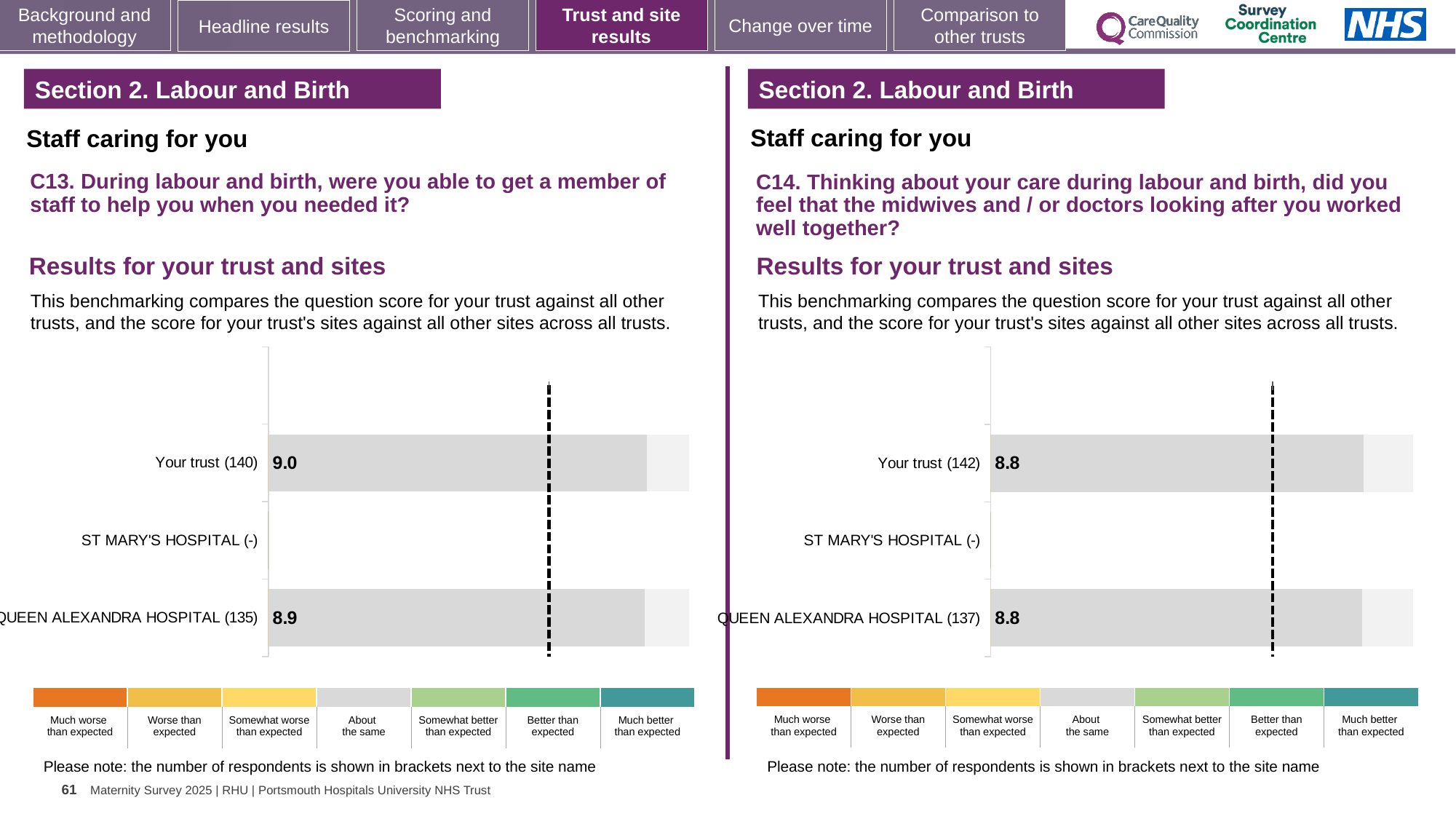
In the C14 chart on the right, what is the score for Your trust (142)? 8.8 How many site/trust categories are listed on the y axis of the C13 chart on the left? 3 In the C13 chart on the left, which category has the lowest printed score? QUEEN ALEXANDRA HOSPITAL (135) In the C14 chart on the right, what is the difference between the score for Your trust and the score for QUEEN ALEXANDRA HOSPITAL? 0.0 In the C13 chart on the left, how many respondents are shown in brackets for Your trust? 140 In the C13 chart on the left, what is the difference between the score for Your trust and the score for QUEEN ALEXANDRA HOSPITAL? 0.1 In the C13 chart on the left, which has the higher score, Your trust or QUEEN ALEXANDRA HOSPITAL? Your trust In the C13 chart on the left, what is the score for QUEEN ALEXANDRA HOSPITAL (135)? 8.9 What kind of chart is used for the C14 results on the right? Bar chart In the C14 chart on the right, what is the score for QUEEN ALEXANDRA HOSPITAL (137)? 8.8 In the C13 chart on the left, what is the score for Your trust (140)? 9.0 In the C14 chart on the right, how many respondents are shown in brackets for QUEEN ALEXANDRA HOSPITAL? 137